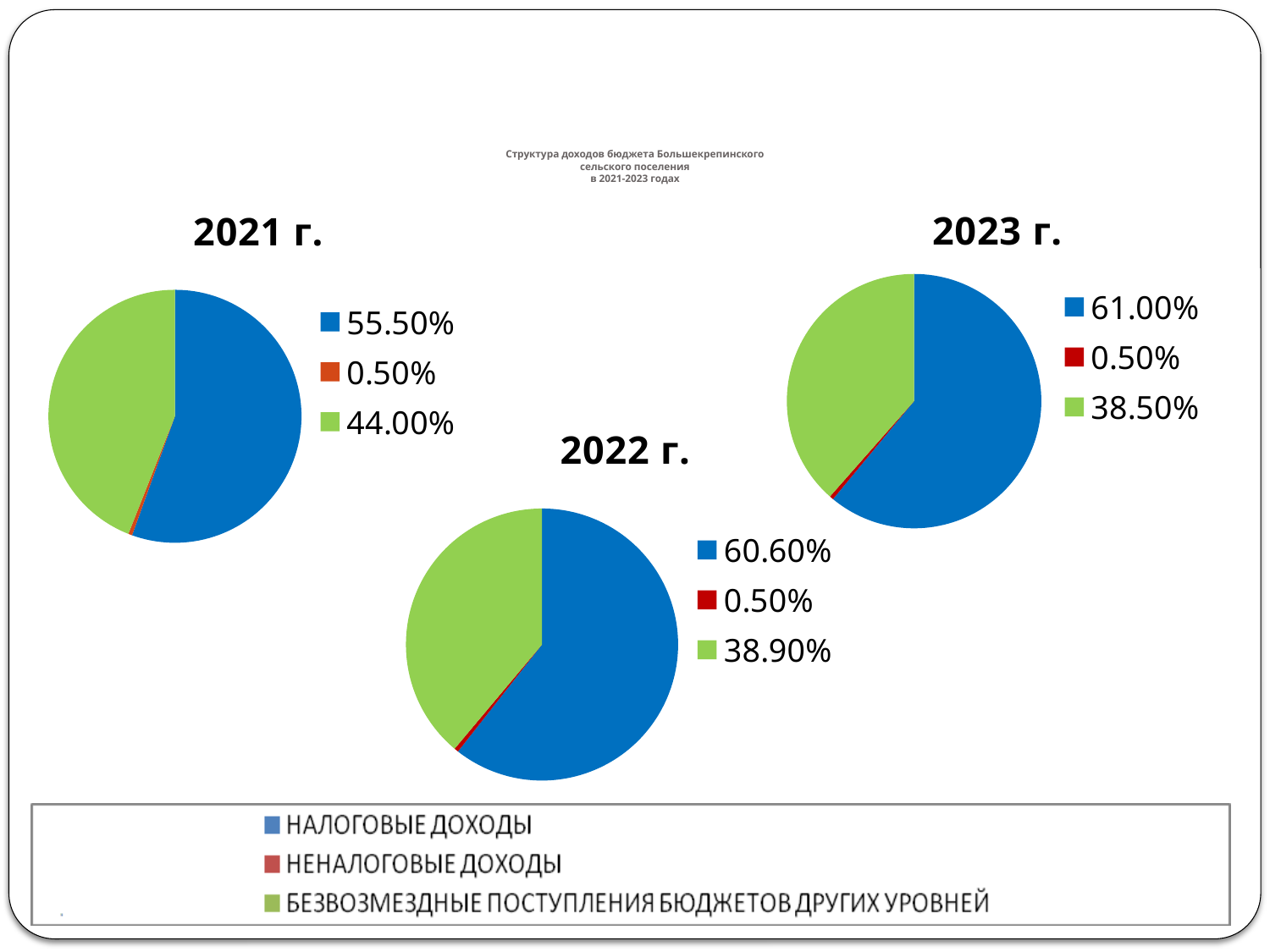
In the 2022 г. pie chart, what share is shown for the blue slice (НАЛОГОВЫЕ ДОХОДЫ)? 60.60% In the 2021 г. pie chart, what share is shown for the green slice (БЕЗВОЗМЕЗДНЫЕ ПОСТУПЛЕНИЯ БЮДЖЕТОВ ДРУГИХ УРОВНЕЙ)? 44.00% In the 2022 г. pie chart, what share is shown for the green slice (БЕЗВОЗМЕЗДНЫЕ ПОСТУПЛЕНИЯ БЮДЖЕТОВ ДРУГИХ УРОВНЕЙ)? 38.90% What is the difference between the blue slice (НАЛОГОВЫЕ ДОХОДЫ) in the 2023 г. chart and the blue slice in the 2021 г. chart? 5.50% In the 2021 г. pie chart, what share is shown for the blue slice (НАЛОГОВЫЕ ДОХОДЫ)? 55.50% What type of chart is used for 2021 г., 2022 г. and 2023 г.? Pie chart How many slices does the 2022 г. pie chart have? 3 In the 2023 г. pie chart, which category has the largest share? НАЛОГОВЫЕ ДОХОДЫ In the 2021 г. pie chart, which category has the smallest share? НЕНАЛОГОВЫЕ ДОХОДЫ In the 2023 г. pie chart, what share is shown for the red slice (НЕНАЛОГОВЫЕ ДОХОДЫ)? 0.50% Which is larger: the green slice in the 2021 г. chart or the green slice in the 2022 г. chart? 2021 г. (44.00%) In the 2023 г. pie chart, what share is shown for the blue slice (НАЛОГОВЫЕ ДОХОДЫ)? 61.00%